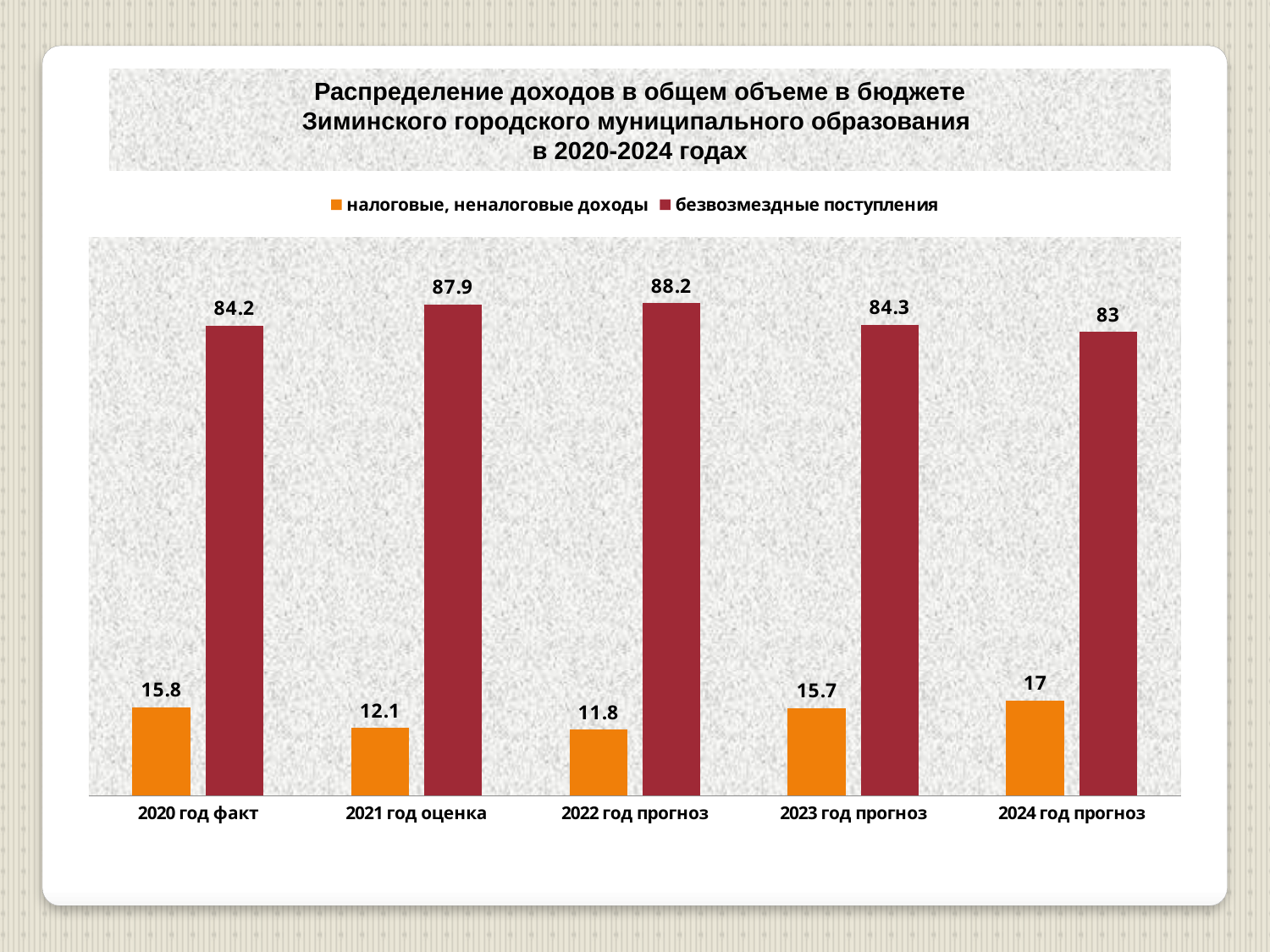
Which colour represents безвозмездные поступления in the legend? dark red What is the value of налоговые, неналоговые доходы for 2020 год факт? 15.8 Which is larger: налоговые, неналоговые доходы for 2020 год факт or for 2023 год прогноз? 2020 год факт What is the value of безвозмездные поступления for 2022 год прогноз? 88.2 Does безвозмездные поступления rise or fall from 2022 год прогноз to 2024 год прогноз? fall In which year is безвозмездные поступления highest? 2022 год прогноз What is the difference between безвозмездные поступления and налоговые, неналоговые доходы for 2021 год оценка? 75.8 In which year is налоговые, неналоговые доходы lowest? 2022 год прогноз How many series does the legend list? 2 How many year categories are shown on the x axis? 5 What kind of chart is shown on the slide? bar chart What is the value of налоговые, неналоговые доходы for 2024 год прогноз? 17